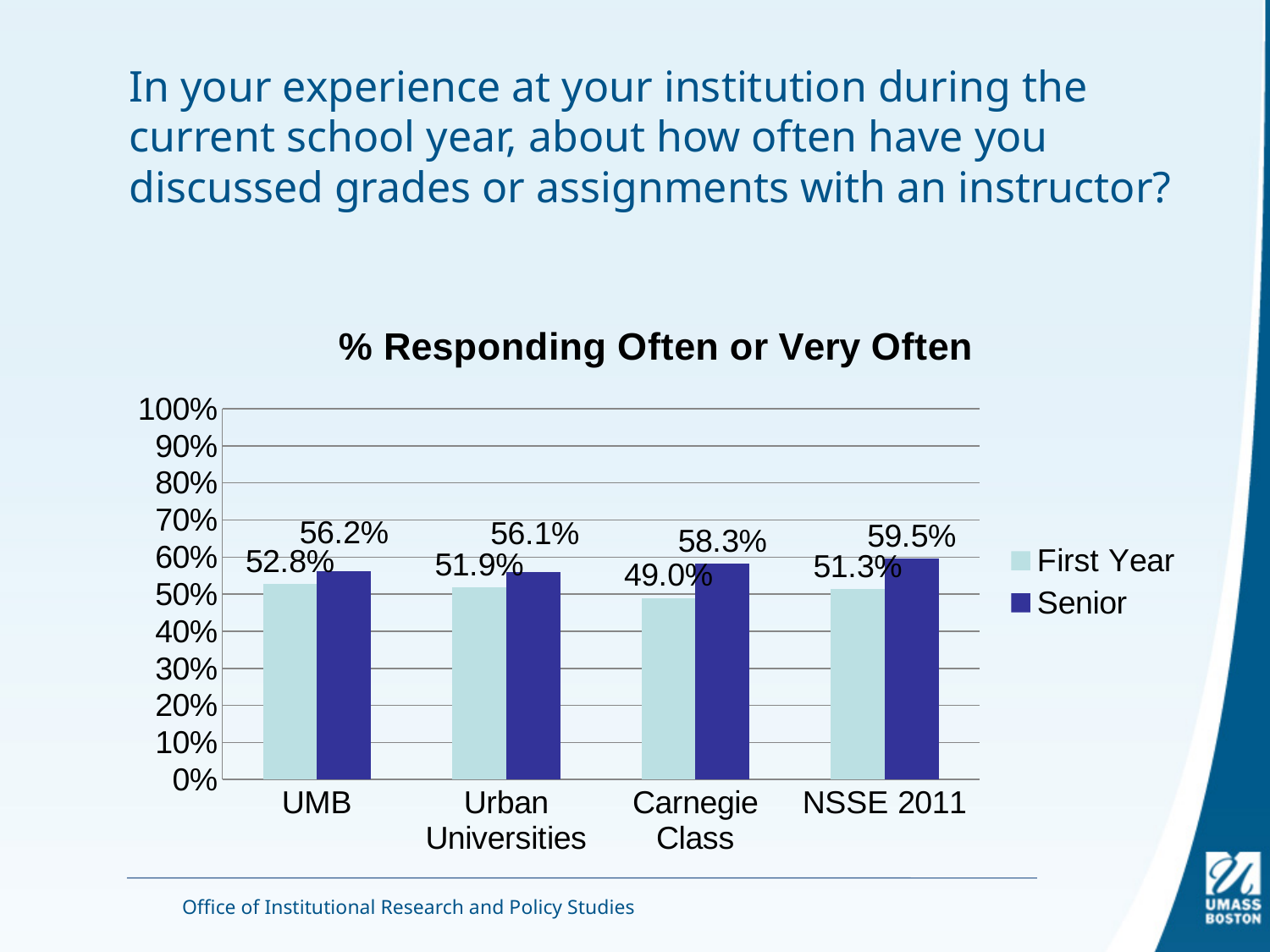
What is the First Year value for UMB? 52.8% What is the Senior value for Urban Universities? 56.1% What is the First Year value for Carnegie Class? 49.0% What kind of chart is shown? Bar chart Which category has the highest Senior value? NSSE 2011 Which is larger, the First Year value for UMB or the First Year value for NSSE 2011? UMB How many categories are shown on the x axis? 4 Which category has the lowest First Year value? Carnegie Class What is the difference between the Senior and First Year values for Carnegie Class? 9.3% What is the title of the chart? % Responding Often or Very Often How many series does the legend list? 2 What is the Senior value for NSSE 2011? 59.5%